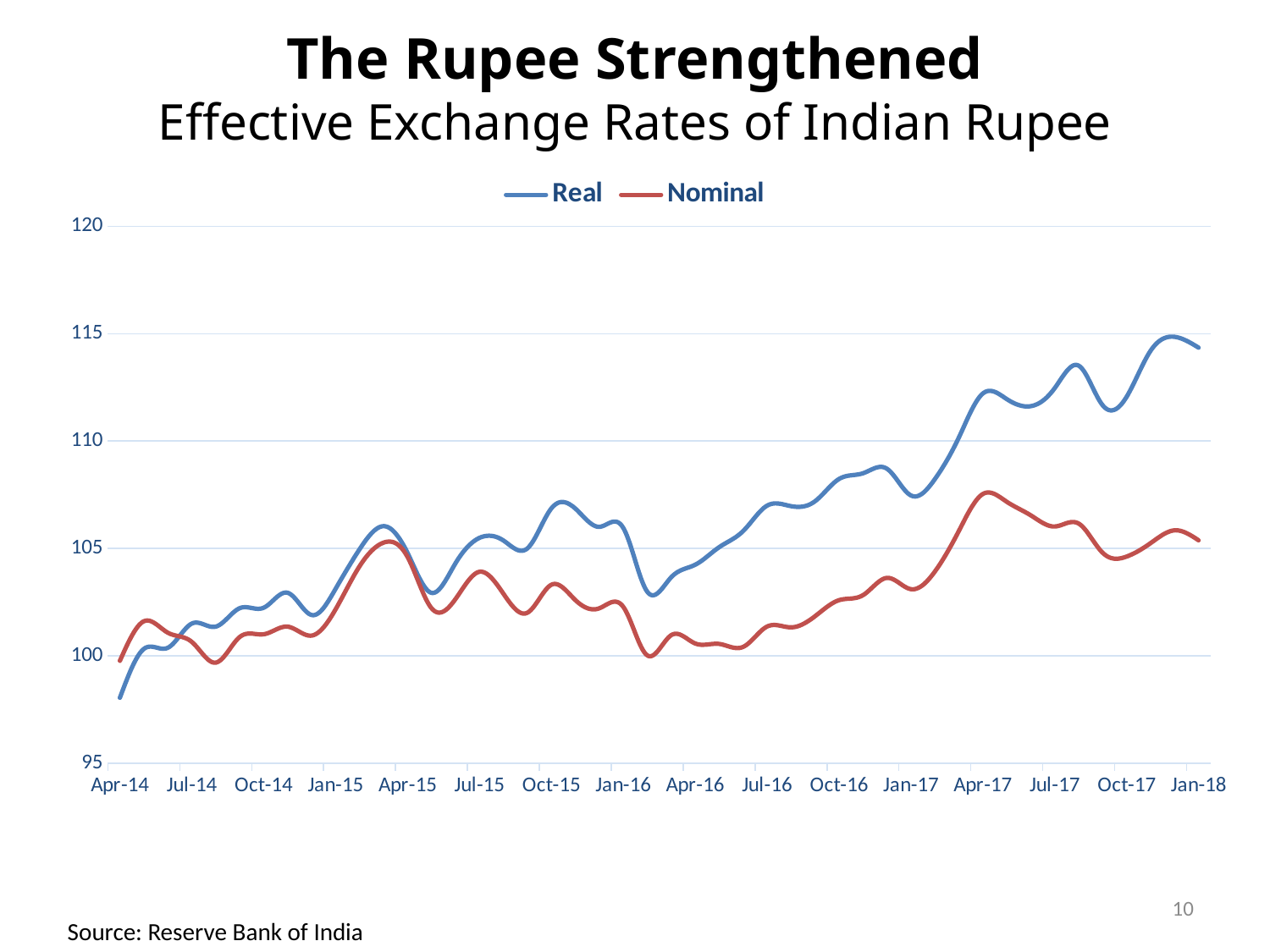
What kind of chart is shown on the slide? line chart Is the value of the Nominal series at Jan-18 greater or less than 110? less Is the value of the Nominal series at Apr-17 greater or less than 105? greater At Jan-17, which series has the higher value, Real or Nominal? Real What are the two series named in the legend? Real and Nominal At Jan-18, which series has the higher value, Real or Nominal? Real Is the value of the Real series at Jan-18 greater or less than 110? greater Does the Real series overall rise or fall from Apr-14 to Jan-18? rise What is the subtitle of the chart below 'The Rupee Strengthened'? Effective Exchange Rates of Indian Rupee How many series does the legend list? 2 Which series reaches the highest value on the chart? Real